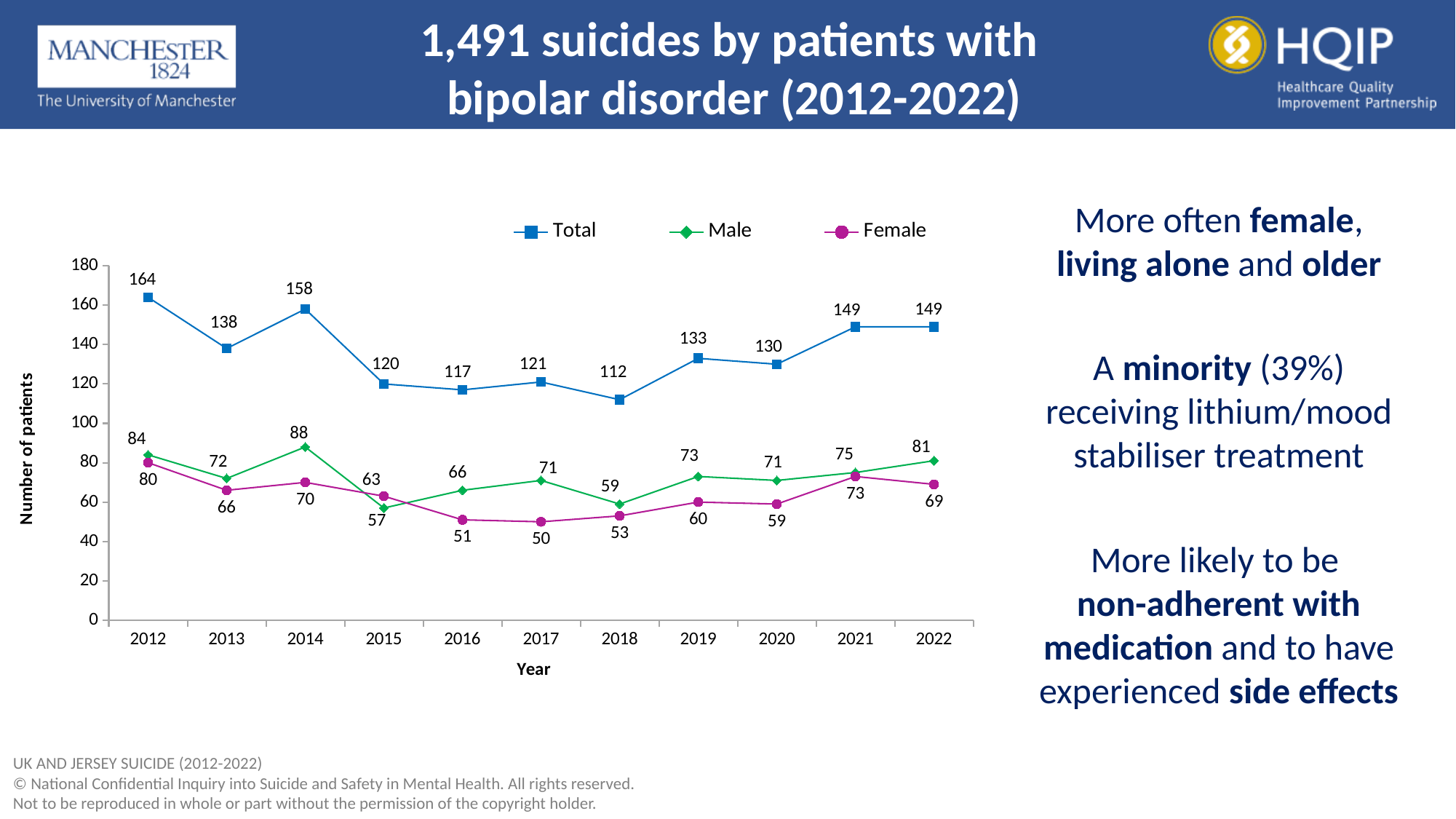
How many series does the legend list? 3 What is the Total number of patients in 2012? 164 What kind of chart is shown on the slide? line chart Is the Total value for 2018 greater or less than 120? less Does the Total series rise or fall from 2014 to 2015? fall What is the Male value in 2022? 81 In which year is the Female series lowest? 2017 What is the Female value in 2017? 50 In which year is the Total series highest? 2012 In 2015, which is larger, the Male value or the Female value? Female What is the difference between the Male and Female values in 2012? 4 How many years are shown on the x axis? 11